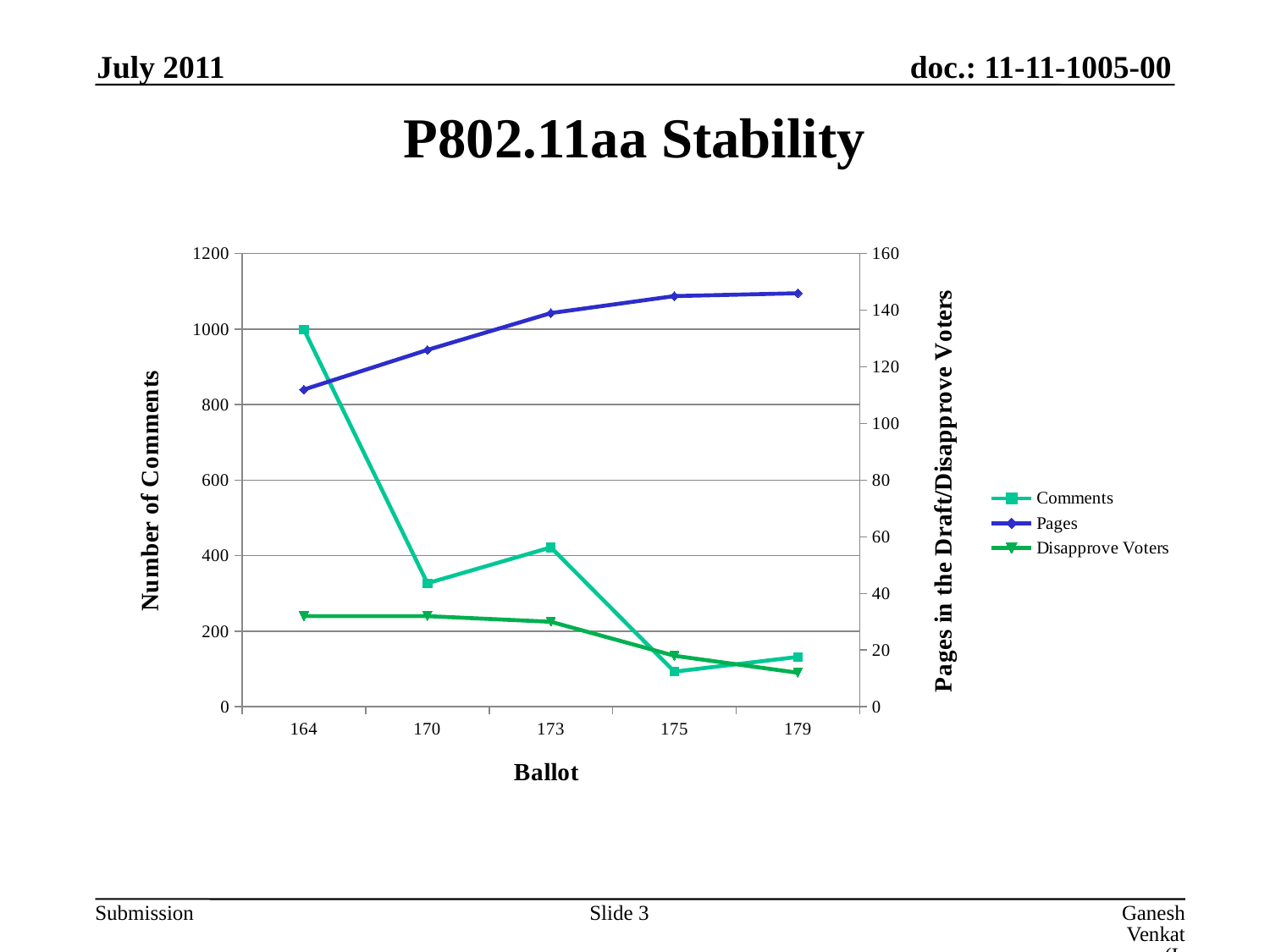
What kind of chart is shown on the slide? line chart What is the title of the left vertical axis? Number of Comments At which ballot is the Pages series lowest? 164 Is the Comments value for ballot 170 greater or less than 600? less Is the Disapprove Voters value for ballot 179 greater or less than 20 on the right axis? less Which ballot has more Comments, 170 or 173? 173 Does the Pages series rise or fall from ballot 164 to ballot 179? rise How many series does the legend list? 3 Is the Comments value for ballot 164 greater or less than 800? greater How many ballots are plotted along the x axis? 5 At which ballot is the Comments series highest? 164